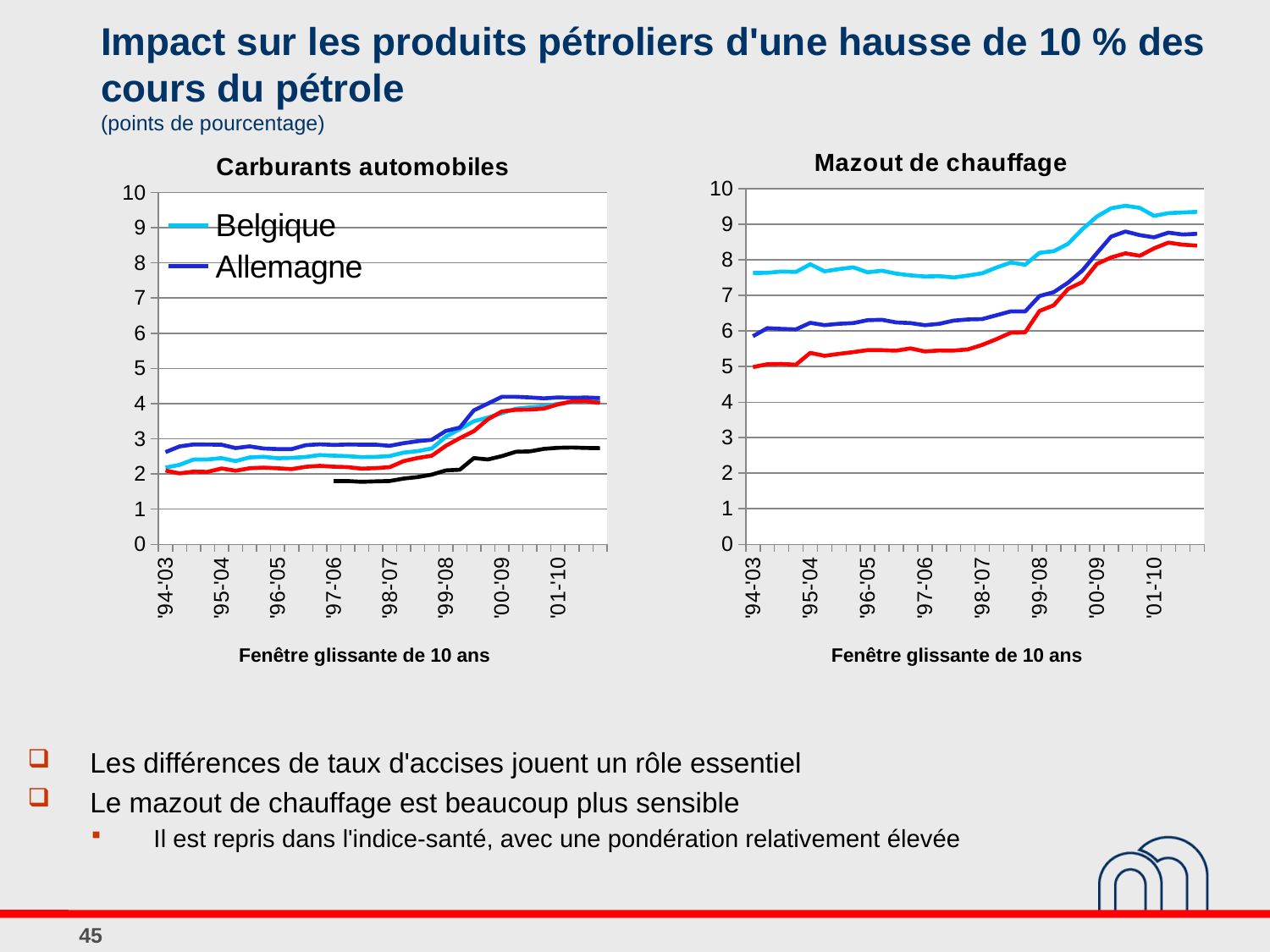
In the "Carburants automobiles" chart, which is higher at '94-'03, Belgique or Allemagne? Allemagne How many x-axis period labels are shown on the "Mazout de chauffage" chart? 8 What kind of chart is the "Mazout de chauffage" chart? line chart In the "Carburants automobiles" chart, is the value for Allemagne at '94-'03 greater or less than 2? greater In the "Carburants automobiles" chart, is the value for Belgique at '94-'03 greater or less than 3? less How many series does the legend of the "Carburants automobiles" chart list? 2 What kind of chart is the "Carburants automobiles" chart? line chart In the "Mazout de chauffage" chart, is the value of the light blue line at '94-'03 greater or less than 7? greater In the "Carburants automobiles" chart, does the Belgique line rise or fall from '94-'03 to '01-'10? rise In the "Mazout de chauffage" chart, does the red line rise or fall from '94-'03 to '01-'10? rise What is the x-axis label of the "Carburants automobiles" chart? Fenêtre glissante de 10 ans